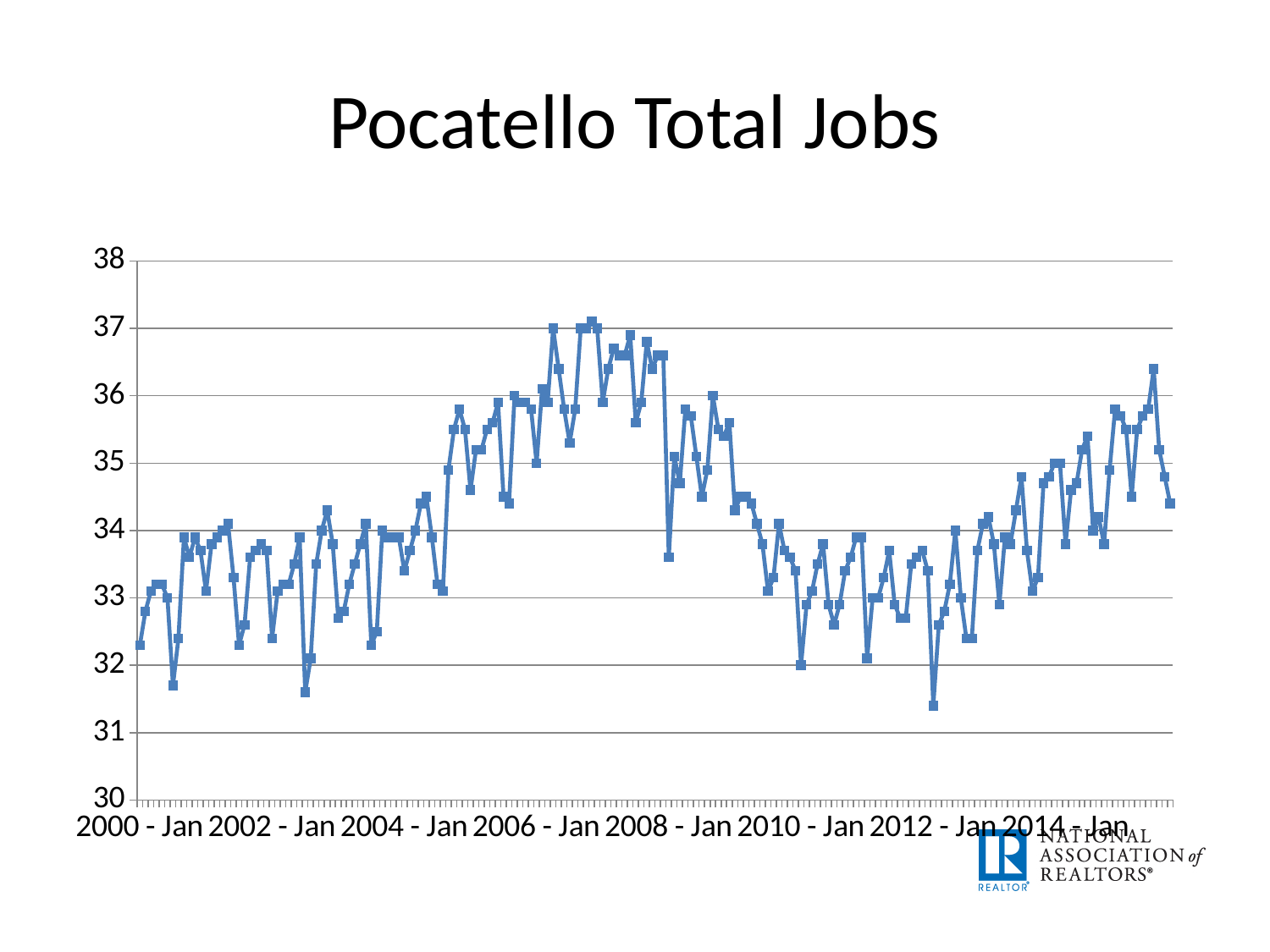
Is the peak value reached around 2007-2008 greater or less than 36? greater Which is larger, the value at 2000 - Jan or the value at 2006 - Jan? 2006 - Jan What is the title of the chart? Pocatello Total Jobs Do the values generally rise or fall between 2012 - Jan and 2014 - Jan? rise What is the highest value shown on the vertical axis? 38 Is the value at 2010 - Jan greater or less than 34? less What kind of chart is shown on the slide? line chart Is the value at 2000 - Jan greater or less than 33? less Do the values generally rise or fall between 2008 - Jan and 2010 - Jan? fall Which is larger, the value at 2008 - Jan or the value at 2012 - Jan? 2008 - Jan